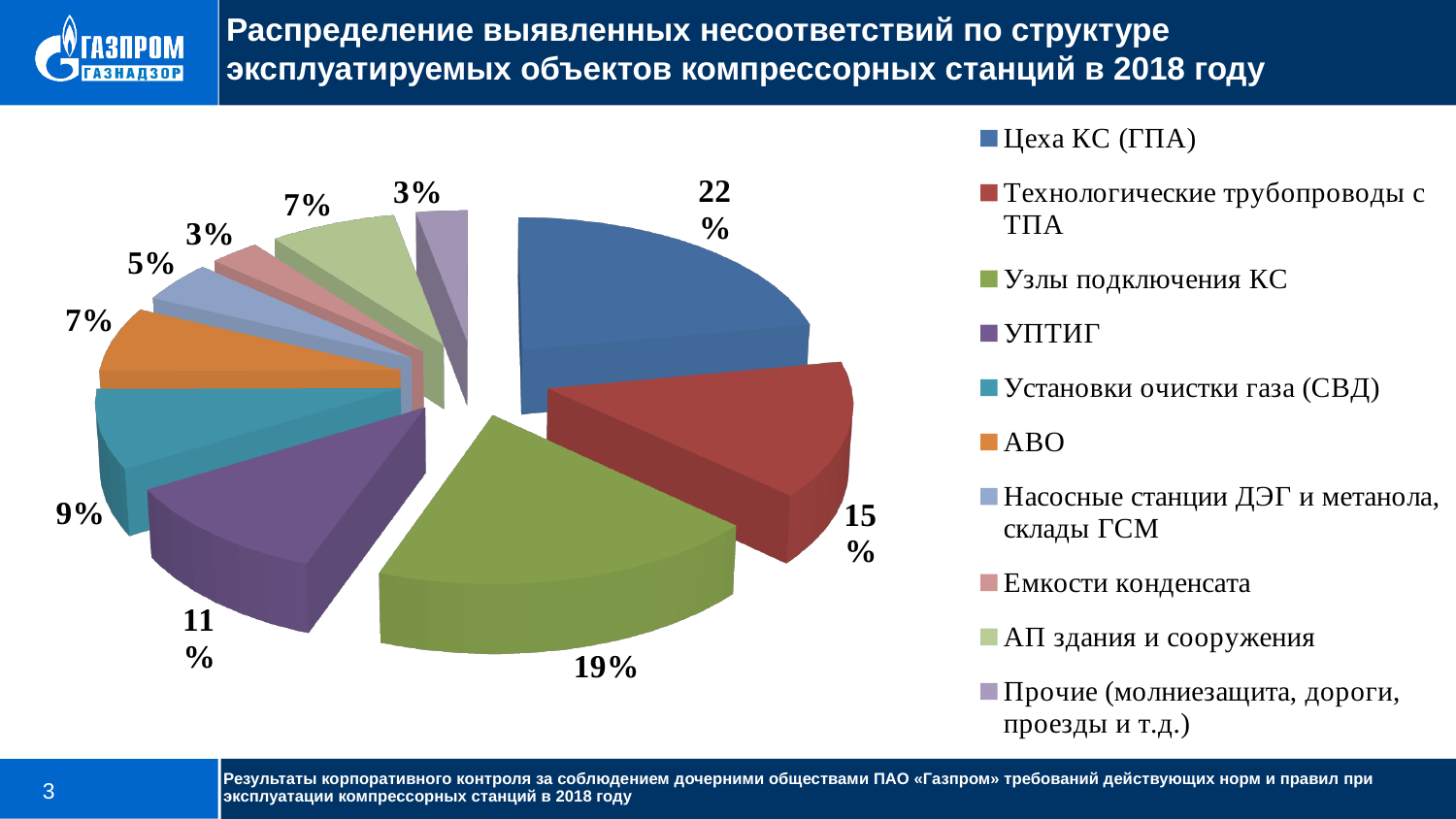
What colour is the slice for АВО? orange What share of the pie does Установки очистки газа (СВД) have? 9% Which is larger, the share for Узлы подключения КС or the share for Технологические трубопроводы с ТПА? Узлы подключения КС What is the difference between the share for Цеха КС (ГПА) and the share for УПТИГ? 11% Which category has the largest share of the pie? Цеха КС (ГПА) What share of the pie does Цеха КС (ГПА) have? 22% What share of the pie does УПТИГ have? 11% How many categories does the legend list? 10 What kind of chart is shown on the slide? pie chart What share of the pie does Насосные станции ДЭГ и метанола, склады ГСМ have? 5% What share of the pie does Технологические трубопроводы с ТПА have? 15% What share of the pie does Узлы подключения КС have? 19%